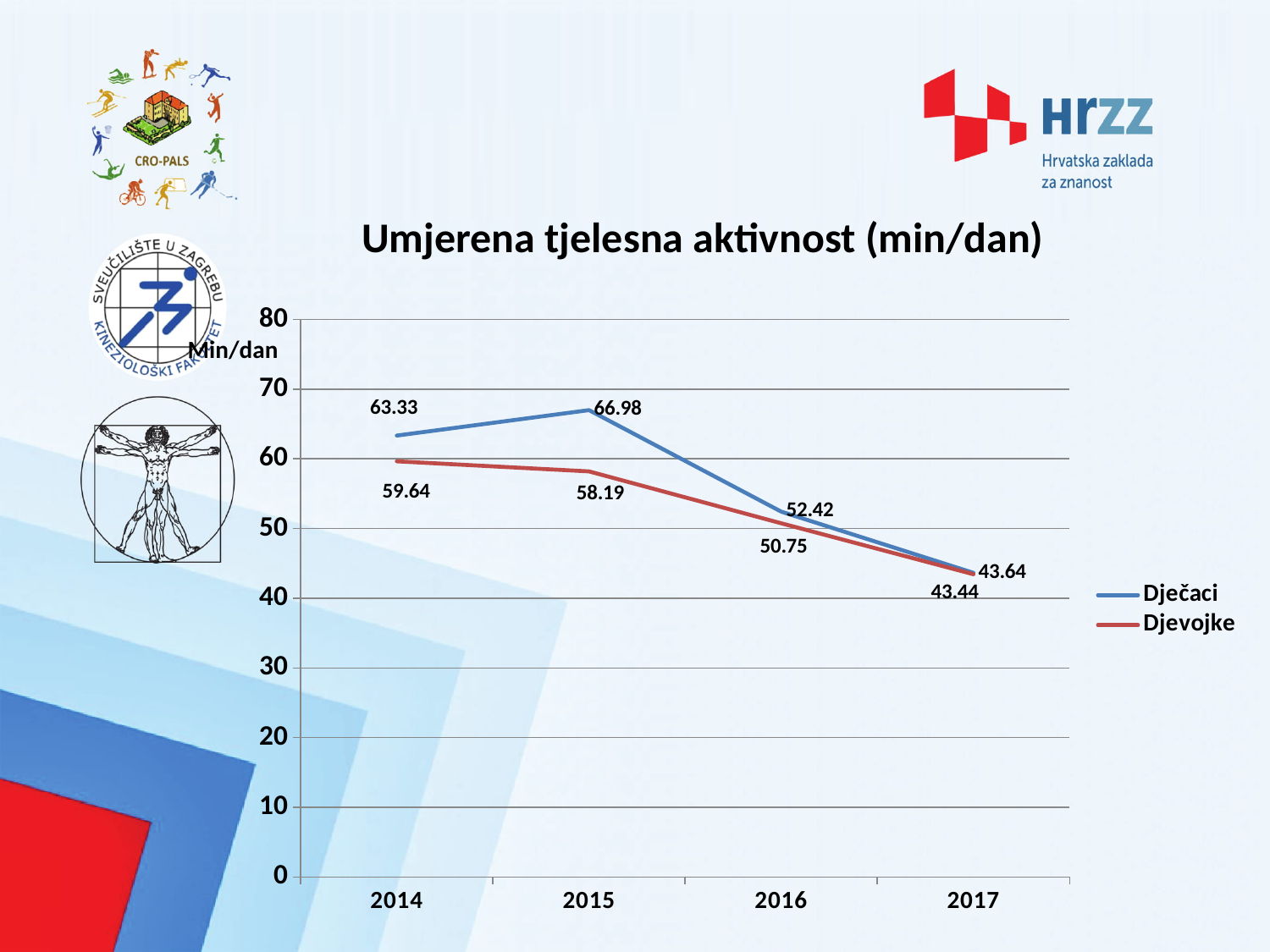
How many years are shown on the x axis? 4 What kind of chart is shown? line chart In which year is the Dječaci value highest? 2015 What is the value for Djevojke in 2017? 43.44 What is the value for Djevojke in 2014? 59.64 How many series does the legend list? 2 Is the value for Dječaci in 2014 greater or less than 60? greater Which is larger in 2016, the Dječaci value or the Djevojke value? Dječaci Does the Djevojke series rise or fall from 2014 to 2017? fall What is the value for Dječaci in 2015? 66.98 What is the difference between the Dječaci and Djevojke values in 2015? 8.79 In which year is the Djevojke value lowest? 2017